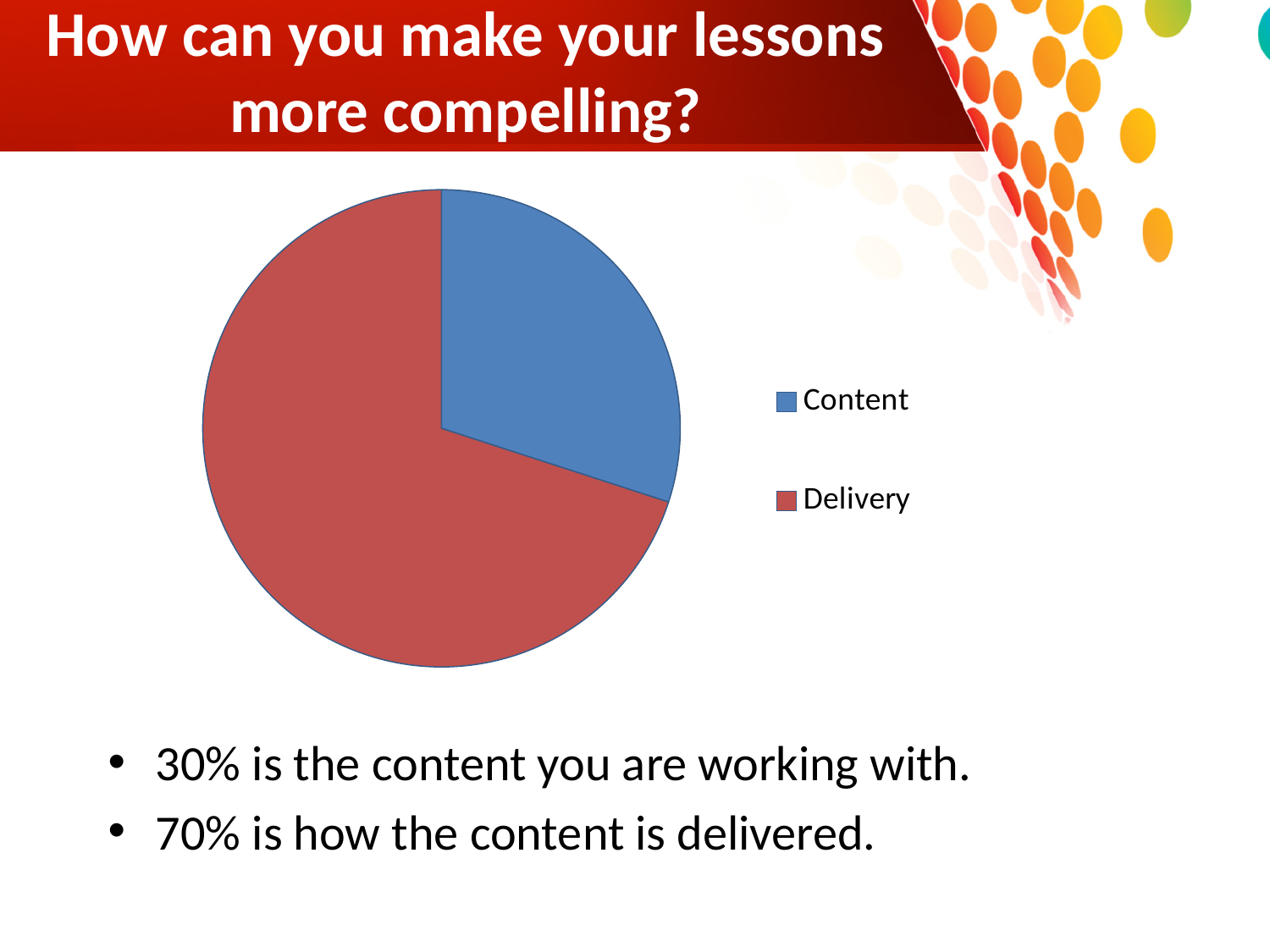
Which slice of the pie chart is the smallest? Content What colour is the Content slice in the pie chart? blue Which slice of the pie chart is the largest? Delivery By how many percentage points does Delivery exceed Content in the pie chart? 40% How many slices does the pie chart have? 2 What kind of chart is shown on the slide? pie chart Which is larger in the pie chart, Content or Delivery? Delivery Is the Delivery slice greater or less than half of the pie? greater What share of the pie does the Delivery slice represent? 70% What share of the pie does the Content slice represent? 30% How many entries does the legend of the pie chart list? 2 What colour is the Delivery slice in the pie chart? red